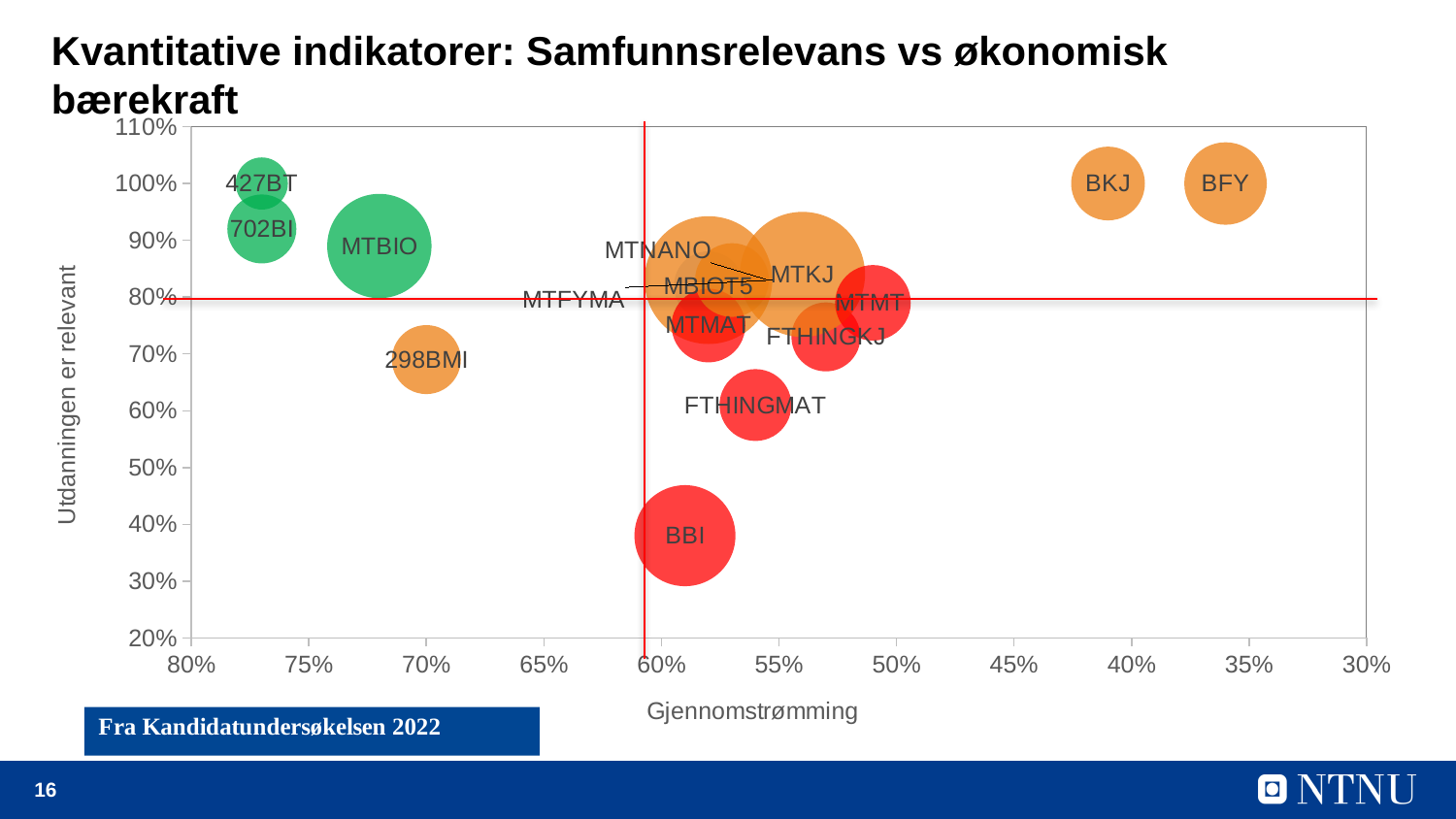
Is the 'Utdanningen er relevant' value for 298BMI greater or less than 80%? less Which programme has the lowest value on the 'Utdanningen er relevant' axis? BBI Is the 'Utdanningen er relevant' value for BKJ greater or less than 90%? greater How many labelled programmes (bubbles) are plotted in the chart? 15 What kind of chart is shown on the slide? Bubble chart Is the 'Utdanningen er relevant' value for BBI greater or less than 50%? less Which has a higher 'Utdanningen er relevant' value, FTHINGMAT or BBI? FTHINGMAT Which programme has the lowest Gjennomstrømming value (furthest right on the x axis)? BFY Which has a higher 'Utdanningen er relevant' value, MTBIO or 298BMI? MTBIO What is the label of the vertical axis? Utdanningen er relevant What is the title of the chart on the slide? Kvantitative indikatorer: Samfunnsrelevans vs økonomisk bærekraft